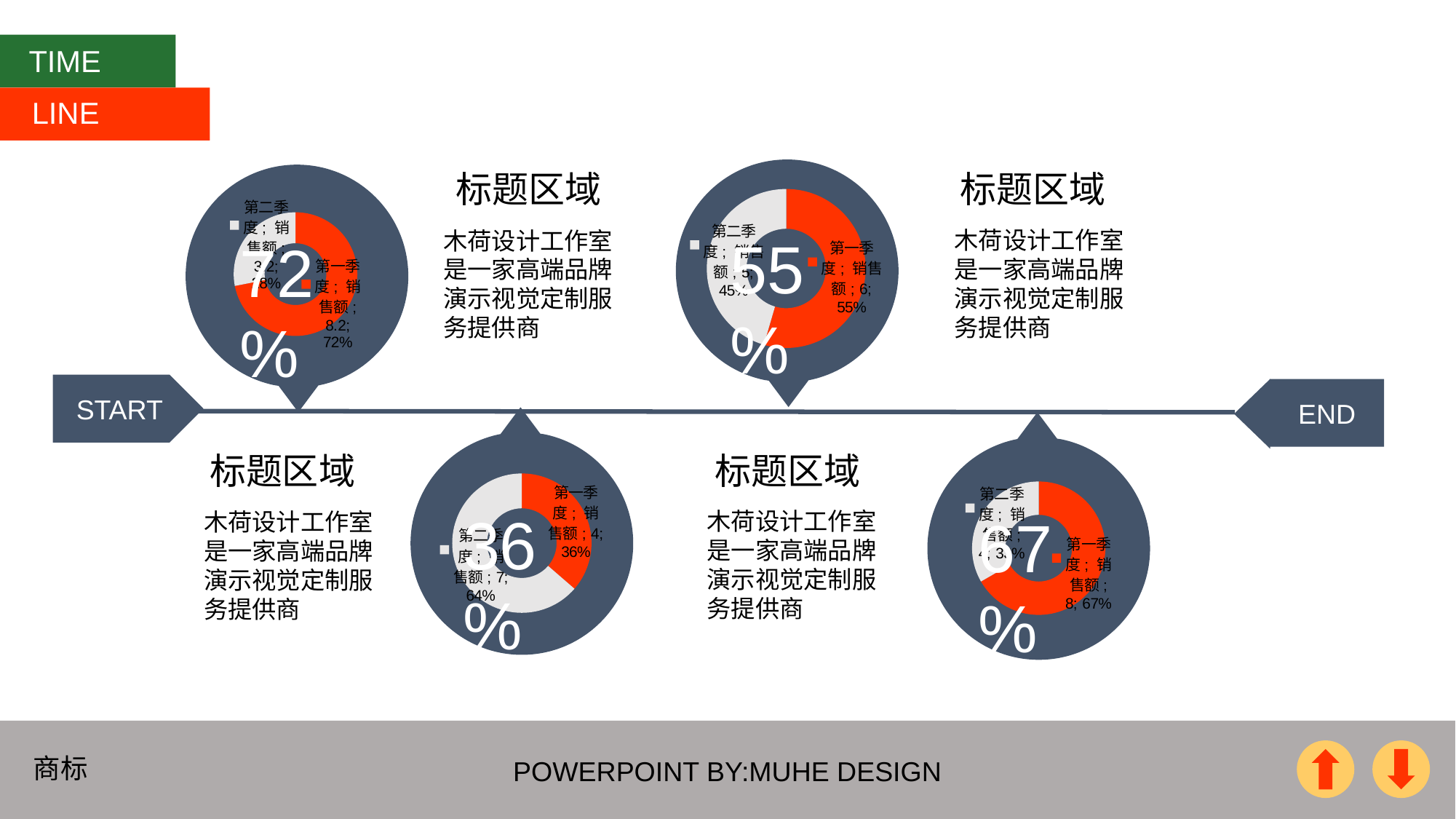
How many slices does the top-right doughnut chart have? 2 In the bottom-left doughnut chart, what share does 第一季度 销售额 represent? 36% In the top-left doughnut chart, what value is shown for 第一季度 销售额? 8.2 In the top-right doughnut chart, what value is shown for 第一季度 销售额? 6 In the top-left doughnut chart, what share of the total does 第一季度 销售额 represent? 72% In the bottom-right doughnut chart, what value is shown for 第一季度 销售额? 8 In the top-right doughnut chart, what value is shown for 第二季度 销售额? 5 In the bottom-left doughnut chart, what is the difference between the 第二季度 销售额 value and the 第一季度 销售额 value? 3 In the bottom-left doughnut chart, which slice is larger, 第一季度 销售额 or 第二季度 销售额? 第二季度 销售额 In the top-right doughnut chart, what share does 第二季度 销售额 represent? 45% What kind of chart is the top-left chart on the slide? doughnut chart In the bottom-left doughnut chart, what value is shown for 第二季度 销售额? 7